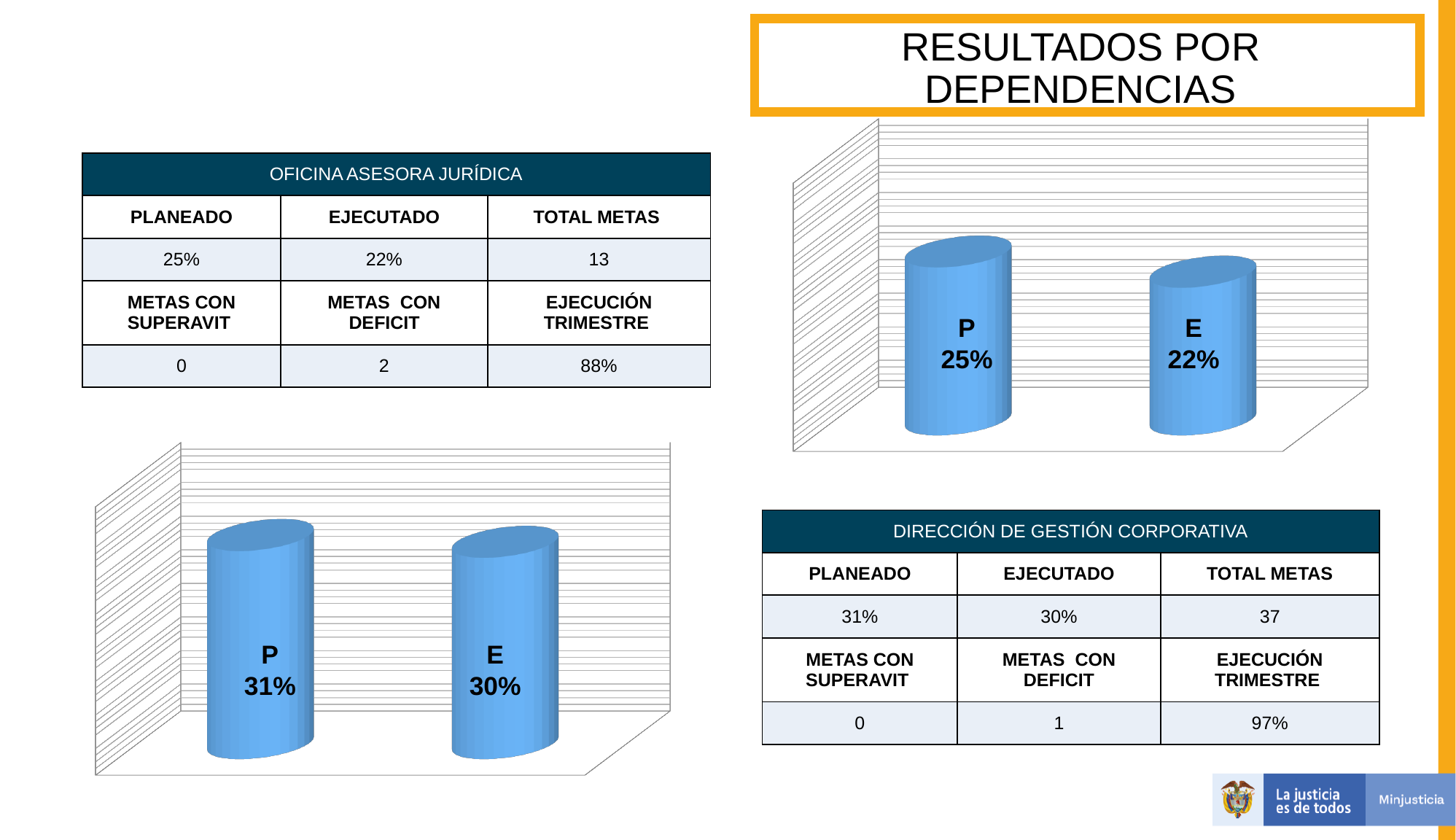
In the chart at the top right of the slide, what is the value for E? 22% In the chart at the top right of the slide, is the value for P larger or smaller than the value for E? larger In the chart at the bottom left of the slide, which category has the lower value? E What colour are the bars in the chart at the bottom left of the slide? blue In the chart at the bottom left of the slide, what is the value for E? 30% What kind of chart is shown at the top right of the slide? bar chart In the chart at the top right of the slide, what is the value for P? 25% In the chart at the bottom left of the slide, what is the difference between the values for P and E? 1% In the chart at the bottom left of the slide, what is the value for P? 31% In the chart at the top right of the slide, which category has the higher value? P In the chart at the top right of the slide, what is the difference between the values for P and E? 3% How many bars are plotted in the chart at the bottom left of the slide? 2